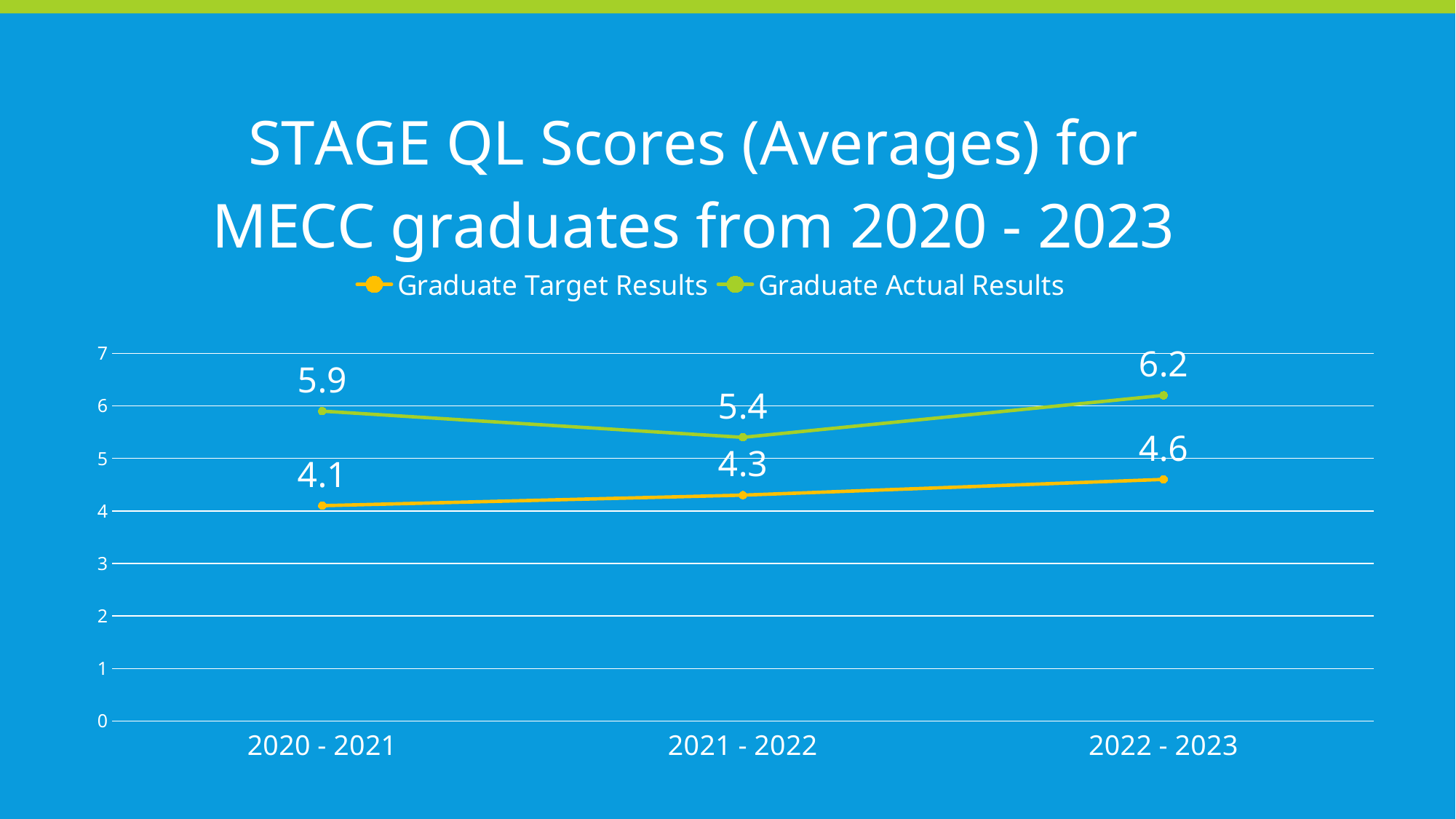
In which period is the Graduate Target Results value lowest? 2020 - 2021 How many periods are shown on the x axis? 3 What is the Graduate Actual Results value for 2020 - 2021? 5.9 Which is larger for 2021 - 2022: Graduate Target Results or Graduate Actual Results? Graduate Actual Results Do the Graduate Target Results values rise or fall from 2020 - 2021 to 2022 - 2023? rise What is the Graduate Actual Results value for 2022 - 2023? 6.2 In which period is the Graduate Actual Results value highest? 2022 - 2023 What is the difference between the Graduate Actual Results and Graduate Target Results values for 2022 - 2023? 1.6 What kind of chart is shown on the slide? line chart What is the Graduate Target Results value for 2021 - 2022? 4.3 Is the Graduate Actual Results value for 2021 - 2022 greater or less than 5? greater How many series does the legend list? 2